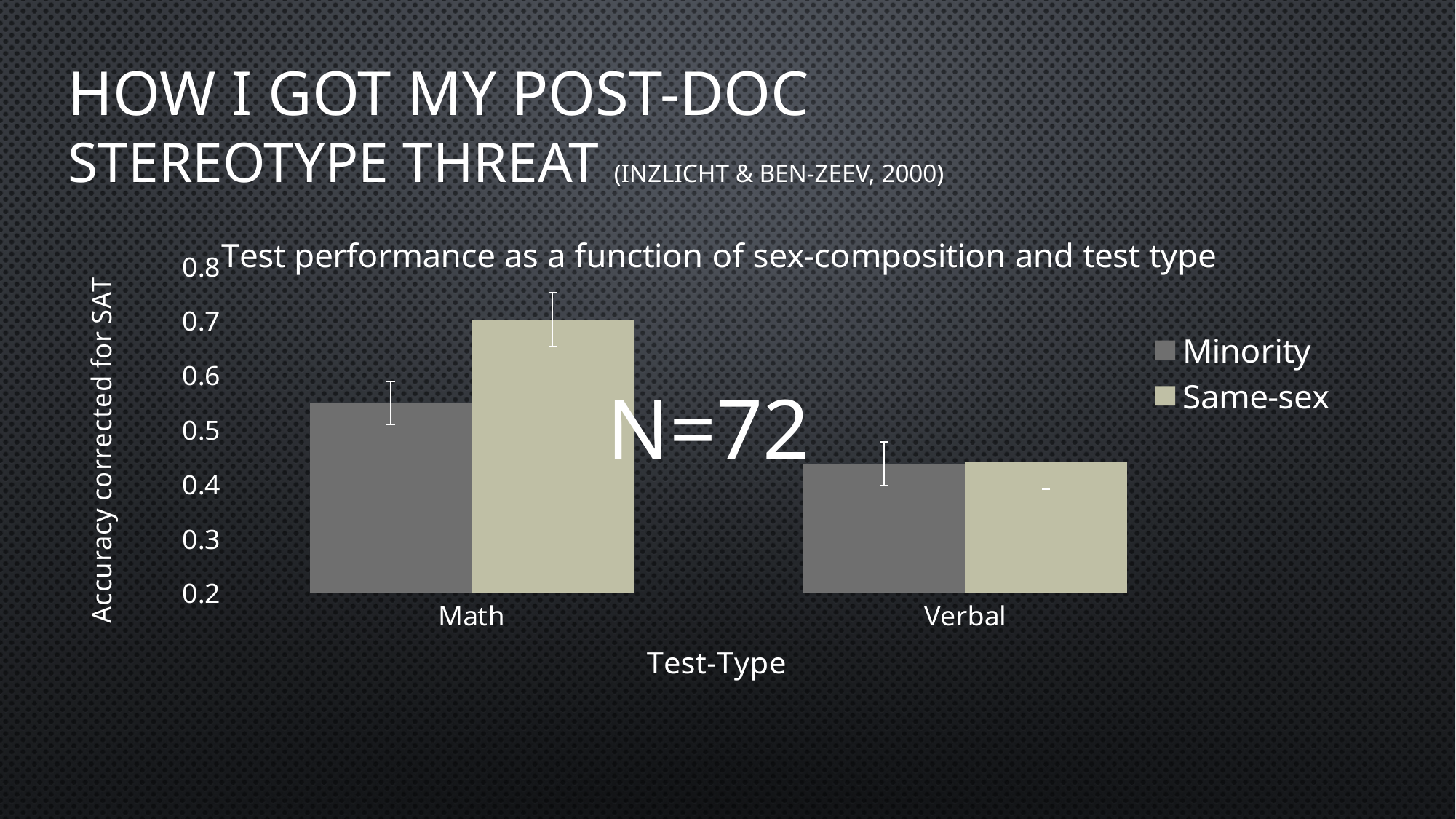
What kind of chart is shown on the slide? Bar chart Is the value for Minority on the Math test greater or less than 0.5? greater Is the value for Same-sex on the Math test greater or less than 0.6? greater Is the value for Minority on the Verbal test greater or less than 0.5? less How many test-type categories are shown on the x axis? 2 What is the title of the chart? Test performance as a function of sex-composition and test type For the Math test, which is larger: Minority or Same-sex? Same-sex How many series does the chart legend list? 2 For the Minority series, which is larger: Math or Verbal? Math What is the label of the vertical axis of the chart? Accuracy corrected for SAT Which bar is the highest in the chart? Same-sex for Math